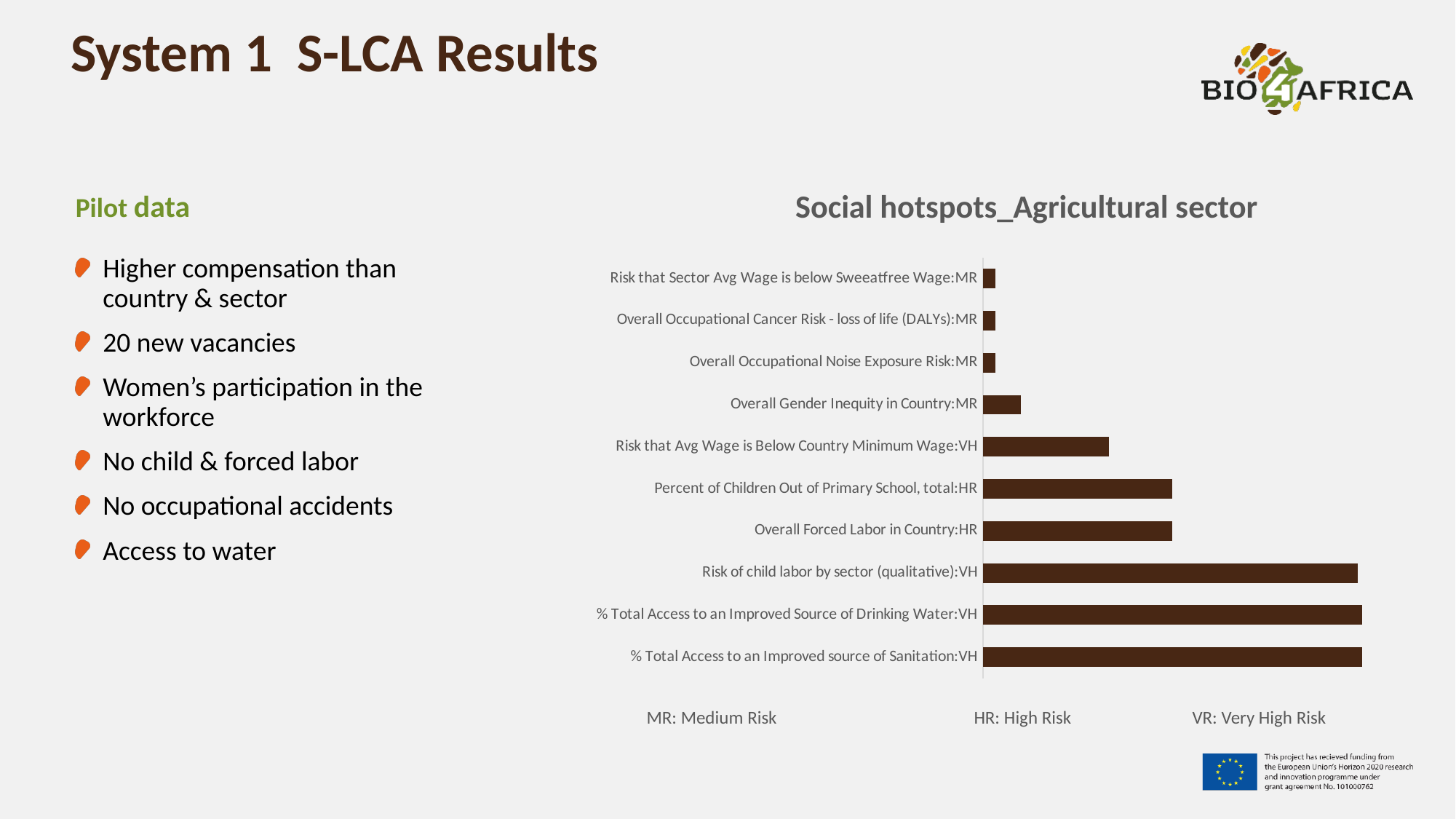
Which bar is longer: "Risk that Avg Wage is Below Country Minimum Wage:VH" or "Overall Gender Inequity in Country:MR"? Risk that Avg Wage is Below Country Minimum Wage:VH What is the title of the chart on the slide? Social hotspots_Agricultural sector Which bar is longer: "Risk of child labor by sector (qualitative):VH" or "Overall Forced Labor in Country:HR"? Risk of child labor by sector (qualitative):VH Which bar is longer: "Percent of Children Out of Primary School, total:HR" or "Risk that Avg Wage is Below Country Minimum Wage:VH"? Percent of Children Out of Primary School, total:HR According to the key below the chart, what does "HR" stand for? High Risk Going from the top category to the bottom category of the chart, do the bars generally get longer or shorter? longer What kind of chart is shown under the title "Social hotspots_Agricultural sector"? bar chart How many categories (bars) does the "Social hotspots_Agricultural sector" chart show? 10